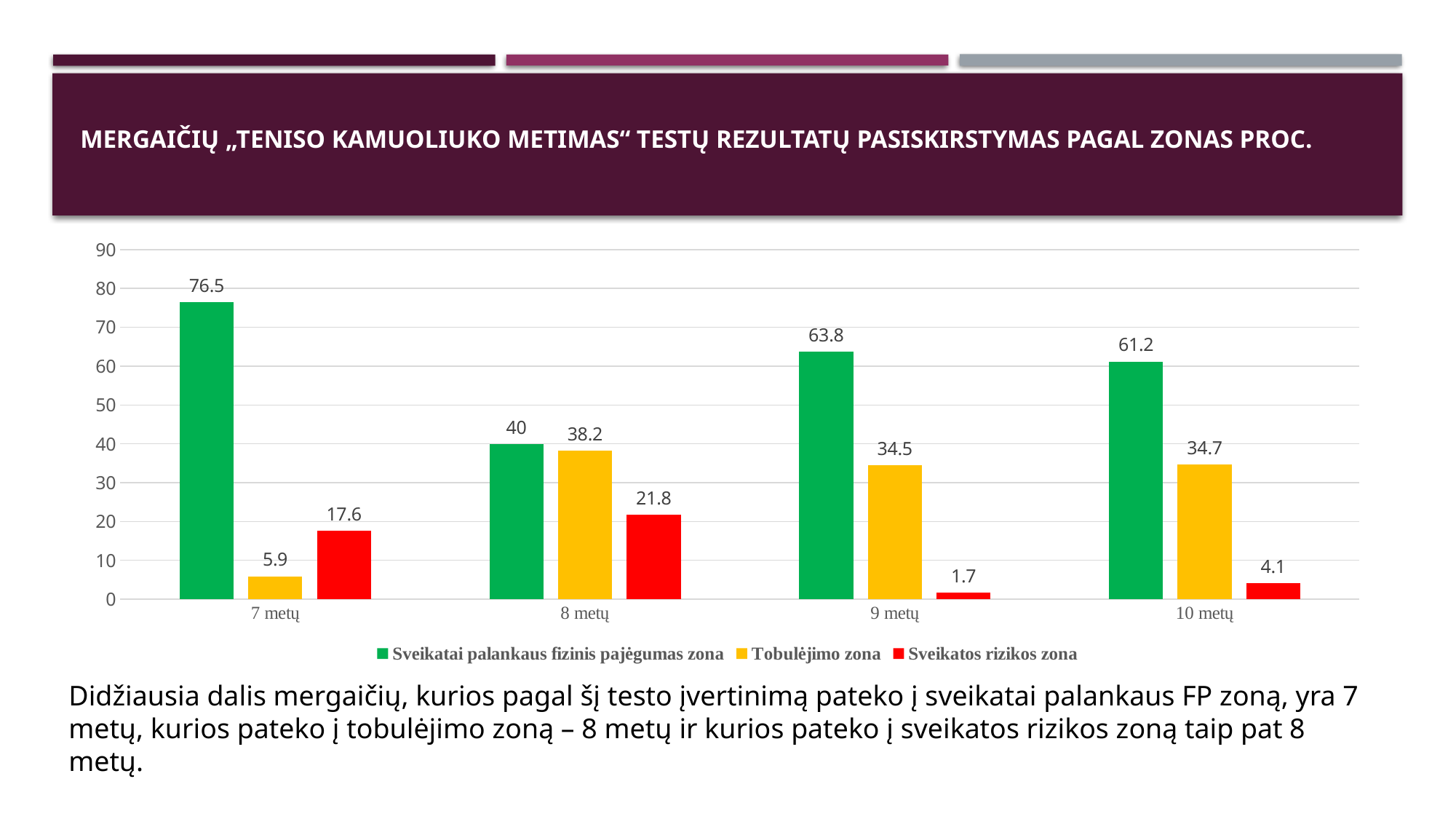
Which is larger: the 'Sveikatos rizikos zona' value for 8 metų or for 10 metų? 8 metų Which age group has the lowest value for 'Sveikatos rizikos zona'? 9 metų What is the value for 'Tobulėjimo zona' for 10 metų? 34.7 Which age group has the highest value for 'Sveikatai palankaus fizinis pajėgumas zona'? 7 metų What is the difference between the 'Sveikatai palankaus fizinis pajėgumas zona' values for 7 metų and 8 metų? 36.5 How many age groups are shown on the x axis? 4 What is the value for 'Tobulėjimo zona' for 8 metų? 38.2 What colour represents 'Sveikatos rizikos zona' in the chart? Red How many series does the legend list? 3 What is the value for 'Sveikatai palankaus fizinis pajėgumas zona' for 7 metų? 76.5 What kind of chart is shown on the slide? Bar chart What is the value for 'Sveikatos rizikos zona' for 9 metų? 1.7